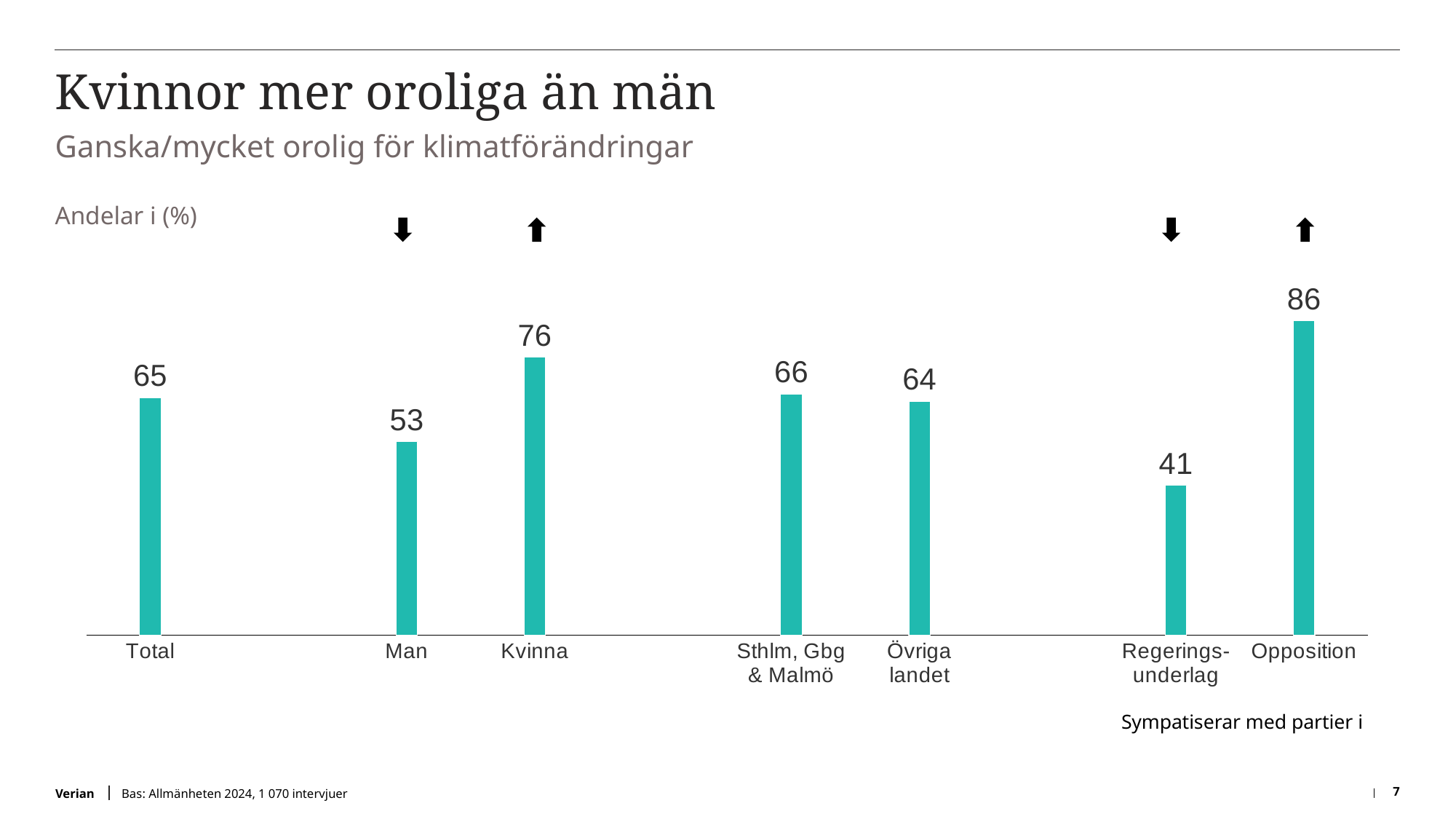
What kind of chart is shown on the slide? Bar chart How many categories are shown in the chart? 7 What is the value for Total? 65 What is the difference between the values for Opposition and Regerings-underlag? 45 Which category has the lowest value? Regerings-underlag What is the difference between the values for Kvinna and Man? 23 What is the value for Kvinna? 76 What is the value for Sthlm, Gbg & Malmö? 66 What is the title of the slide? Kvinnor mer oroliga än män Which category has the highest value? Opposition What is the value for Regerings-underlag? 41 Which is larger, the value for Sthlm, Gbg & Malmö or the value for Övriga landet? Sthlm, Gbg & Malmö